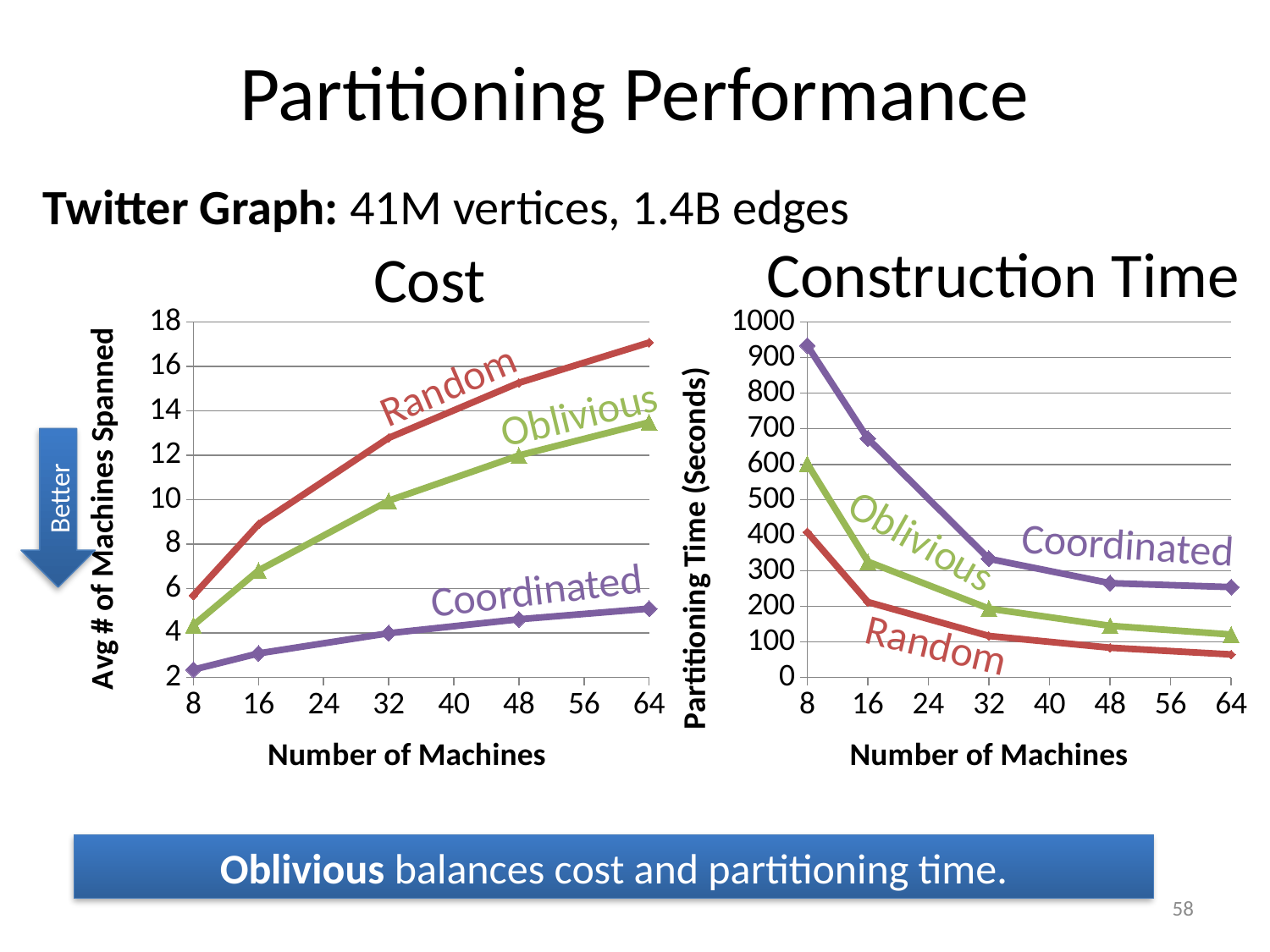
In the Construction Time chart, at 16 machines, which is larger: Oblivious or Random? Oblivious In the Cost chart, is the value for Random at 32 machines greater or less than 12? greater In the Cost chart, does the Random line rise or fall as the number of machines increases? rise In the Construction Time chart, is the value for Coordinated at 8 machines greater or less than 900? greater In the Construction Time chart, does the Coordinated line rise or fall as the number of machines increases? fall In the Construction Time chart, which series has the highest value at 8 machines? Coordinated In the Construction Time chart, which series has the lowest value at 64 machines? Random What kind of chart is the Construction Time chart? line chart In the Cost chart, which series has the lowest value at 64 machines? Coordinated In the Cost chart, which series has the highest value at 64 machines? Random How many series are plotted in the Cost chart? 3 What kind of chart is the Cost chart? line chart